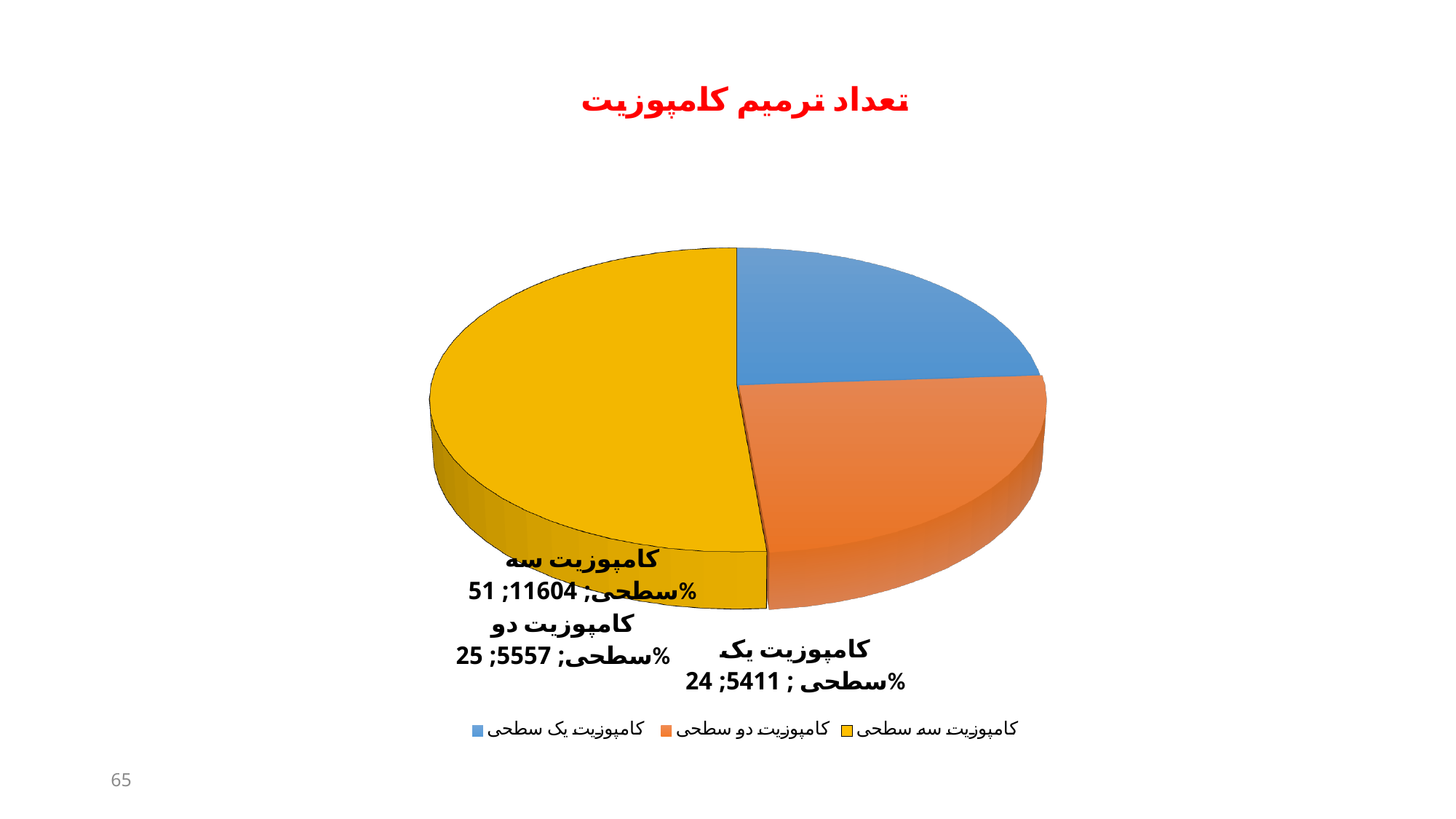
How many entries does the legend list? 3 What is the difference between the values for کامپوزیت سه سطحی and کامپوزیت دو سطحی? 6047 What is the value for کامپوزیت سه سطحی (three-surface composite)? 11604 What is the value for کامپوزیت یک سطحی (one-surface composite)? 5411 Which category has the largest slice? کامپوزیت سه سطحی How many slices does the pie chart have? 3 What kind of chart is shown on the slide? Pie chart What is the value for کامپوزیت دو سطحی (two-surface composite)? 5557 Which colour represents کامپوزیت یک سطحی (one-surface composite) in the chart? Blue What share of the pie does کامپوزیت یک سطحی (one-surface composite) represent? 24% What is the title of the chart? تعداد ترمیم کامپوزیت What share of the pie does کامپوزیت سه سطحی (three-surface composite) represent? 51%